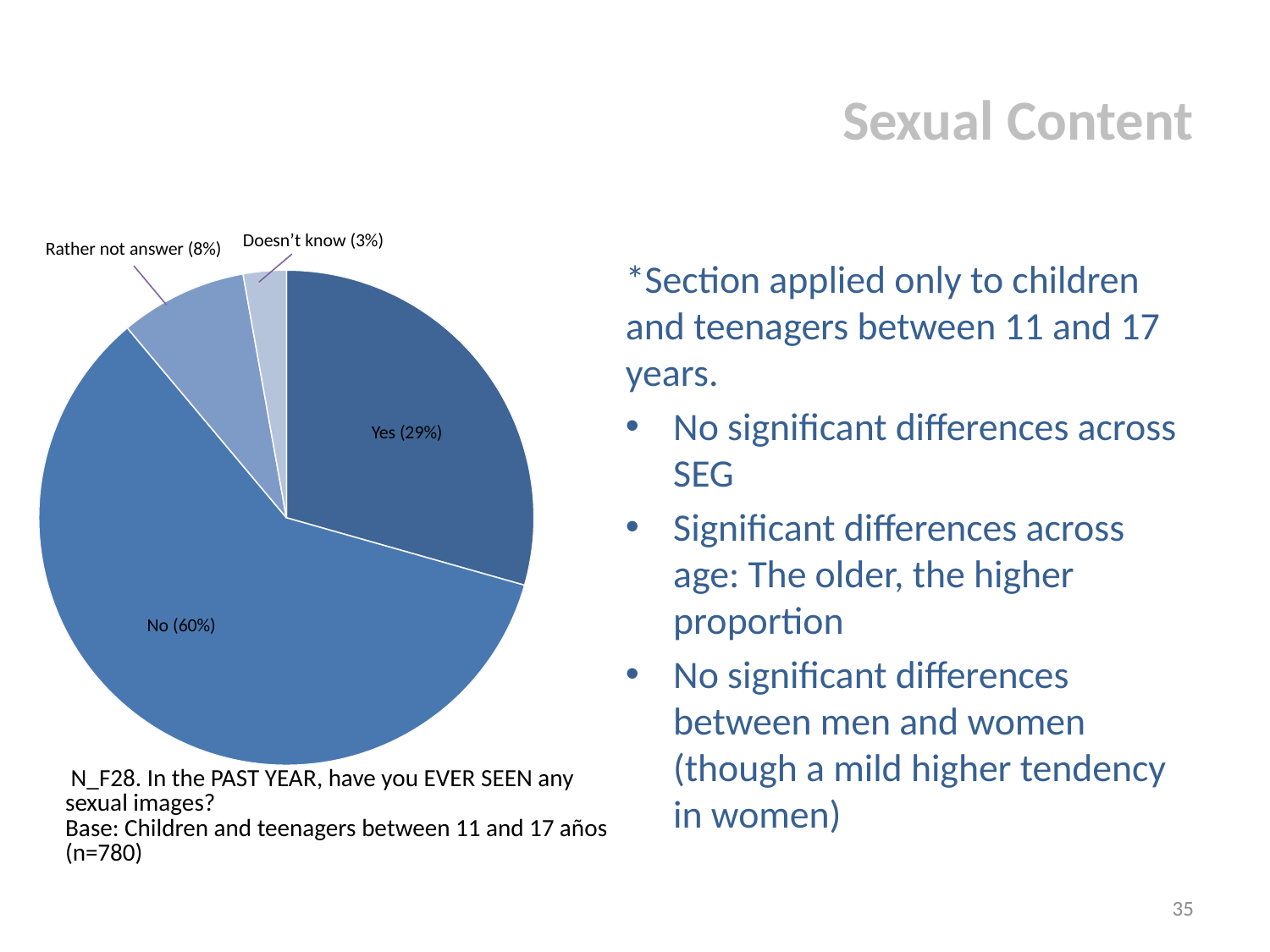
Which response category has the largest share of the pie? No What is the base sample size (n) stated below the chart? 780 What is the combined share of the "Rather not answer" and "Doesn't know" slices? 11% Which slice is larger, "Rather not answer" or "Doesn't know"? Rather not answer Which response category has the smallest share of the pie? Doesn't know What kind of chart is shown on the slide? pie chart What percentage of respondents answered "Yes"? 29% What is the difference in percentage points between the "No" and "Yes" slices? 31 What percentage of respondents answered "No"? 60% What percentage of respondents answered "Doesn't know"? 3% What percentage of respondents answered "Rather not answer"? 8% How many slices does the pie chart have? 4